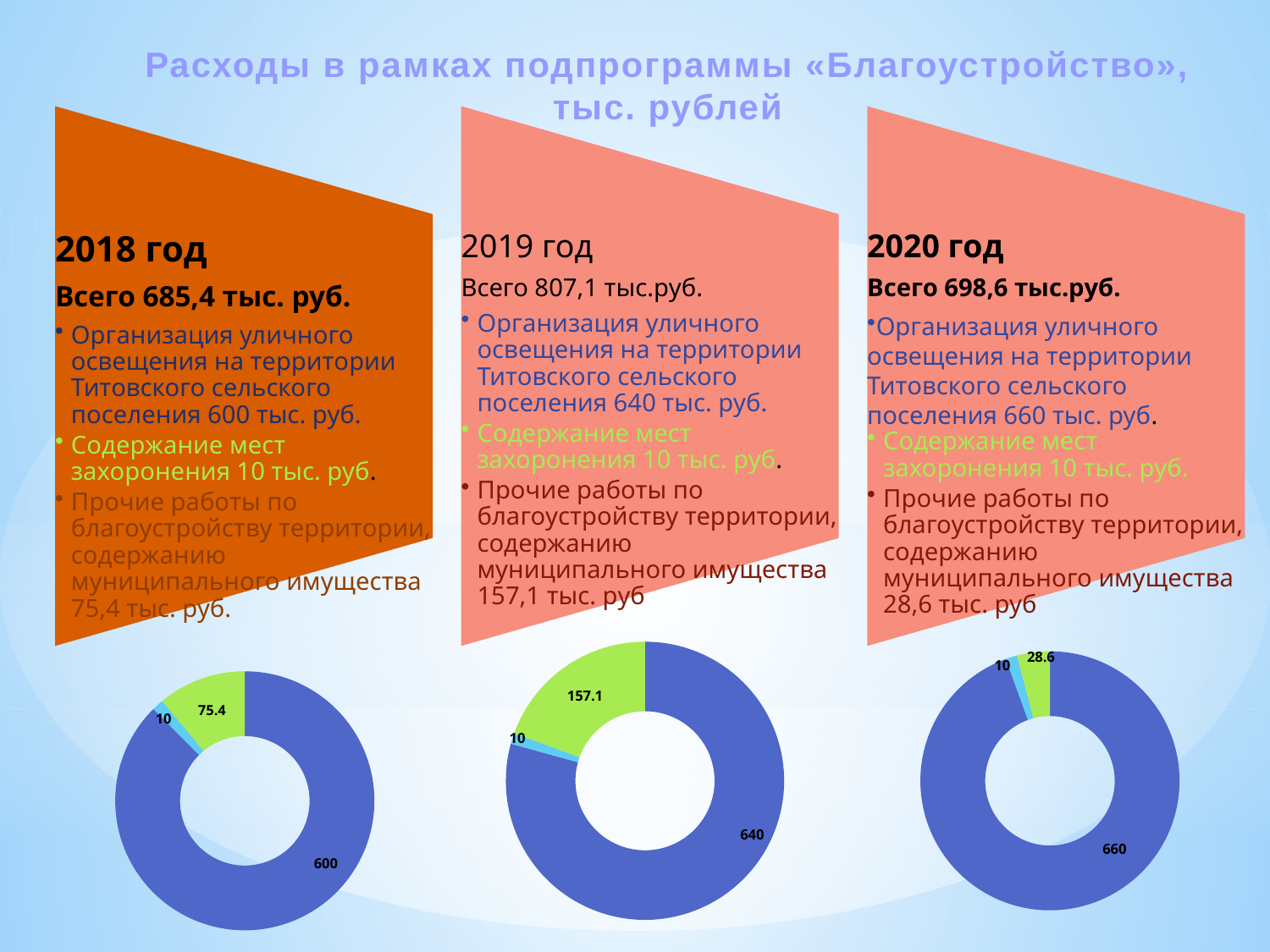
In the right (2020) doughnut chart, what is the value of the smallest slice? 10 In the left (2018) doughnut chart, what is the value of the green slice? 75.4 What is the title of the slide containing the three doughnut charts? Расходы в рамках подпрограммы «Благоустройство», тыс. рублей Does the largest slice value rise or fall from the 2018 chart to the 2019 chart to the 2020 chart? rises (600, 640, 660) In the middle (2019) doughnut chart, which slice is the largest? 640 What kind of chart is used for each of the three years on the slide? doughnut chart In the right (2020) doughnut chart, what is the difference between the largest slice (660) and the green slice (28.6)? 631.4 How many slices does the middle (2019) doughnut chart have? 3 What is the total of the three slices in the left (2018) doughnut chart? 685.4 In the middle (2019) doughnut chart, what is the value of the green slice? 157.1 In the left (2018) doughnut chart, what is the value of the largest slice? 600 Which is larger: the green slice in the middle (2019) chart or the green slice in the right (2020) chart? the middle (2019) chart, 157.1